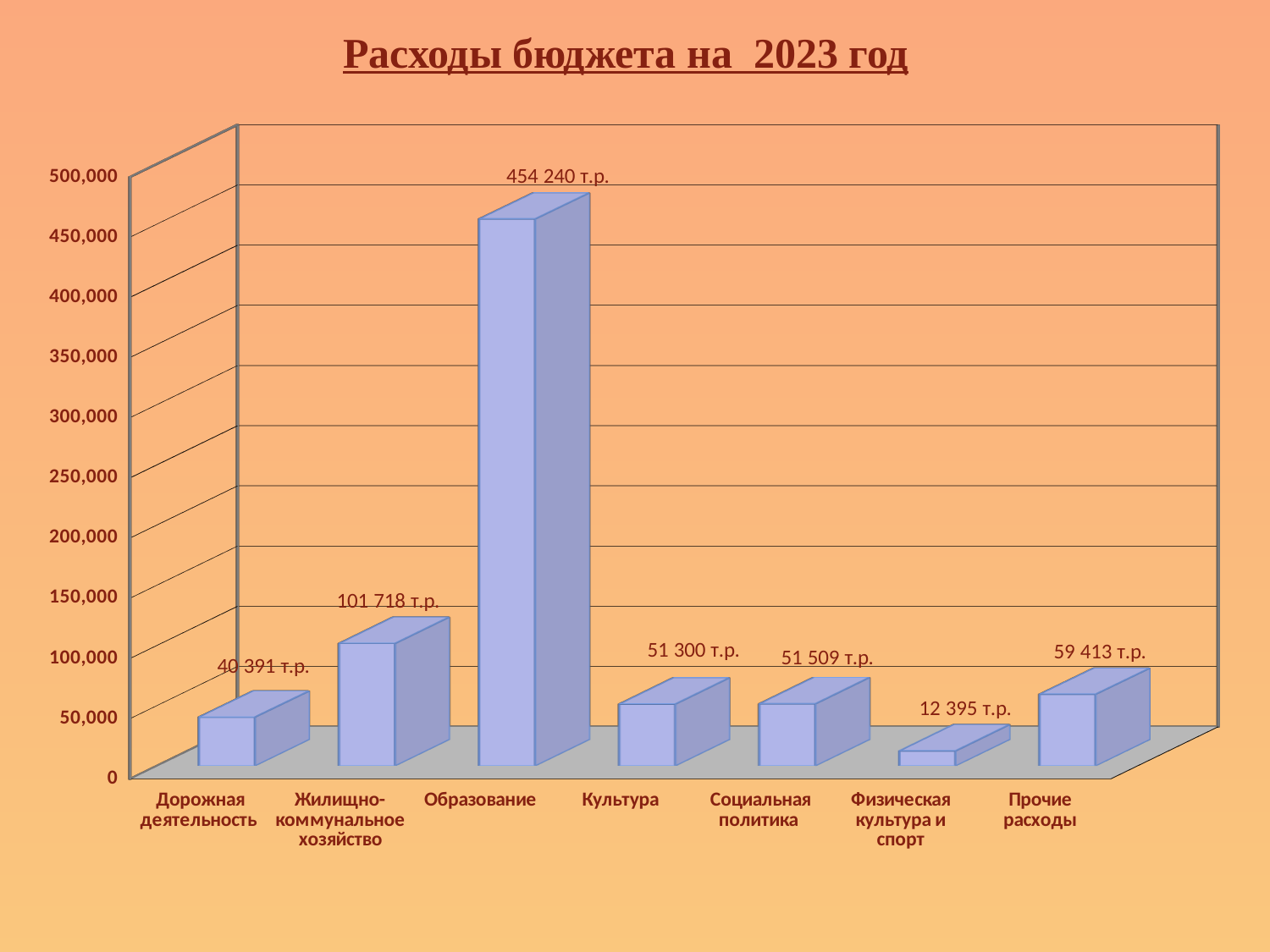
What is the value for Жилищно-коммунальное хозяйство? 101 718 т.р. What type of chart is shown on the slide? Bar chart What is the value for Образование? 454 240 т.р. What is the difference between the values for Образование and Жилищно-коммунальное хозяйство? 352 522 т.р. Which category has the lowest value? Физическая культура и спорт How many categories are shown on the chart? 7 Is the value for Образование greater or less than 400,000? greater What is the title of the chart? Расходы бюджета на 2023 год What is the value for Прочие расходы? 59 413 т.р. What is the value for Физическая культура и спорт? 12 395 т.р. Which is larger, the value for Прочие расходы or the value for Дорожная деятельность? Прочие расходы Which category has the highest value? Образование